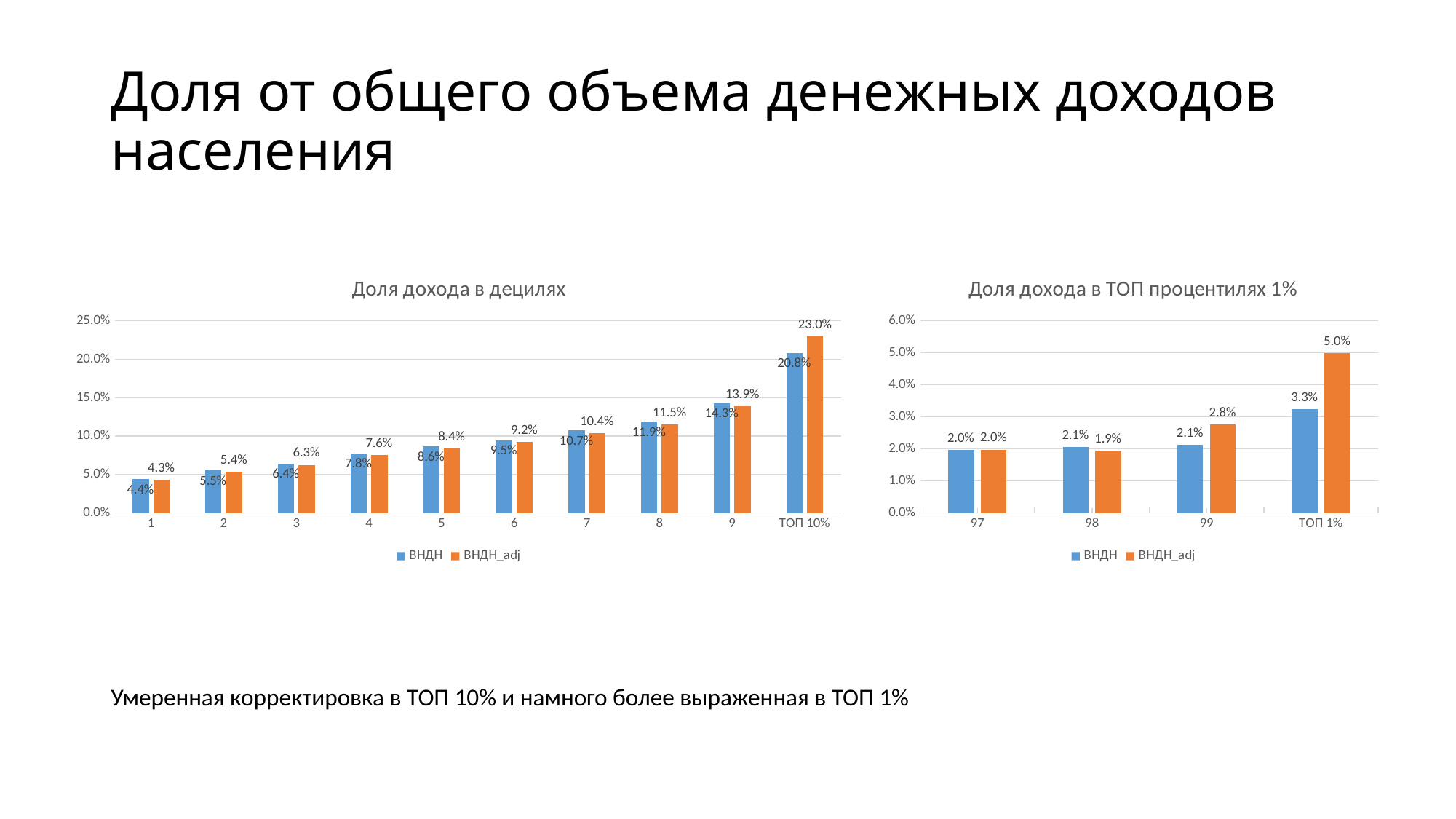
In the chart 'Доля дохода в ТОП процентилях 1%', what is the difference between the ВНДН_adj and ВНДН values for ТОП 1%? 1.7% In the chart 'Доля дохода в децилях', do the ВНДН values rise or fall from decile 1 to decile 9? rise What type of chart is 'Доля дохода в ТОП процентилях 1%'? bar chart In the chart 'Доля дохода в децилях', what is the ВНДН value for decile 5? 8.6% In the chart 'Доля дохода в децилях', what is the ВНДН_adj value for ТОП 10%? 23.0% How many series does the legend of the chart 'Доля дохода в ТОП процентилях 1%' list? 2 In the chart 'Доля дохода в ТОП процентилях 1%', which is larger for percentile 99: ВНДН or ВНДН_adj? ВНДН_adj In the chart 'Доля дохода в децилях', how many categories are shown on the x axis? 10 In the chart 'Доля дохода в ТОП процентилях 1%', what is the ВНДН_adj value for ТОП 1%? 5.0% In the chart 'Доля дохода в децилях', which category has the highest ВНДН value? ТОП 10% In the chart 'Доля дохода в децилях', what is the difference between the ВНДН_adj and ВНДН values for ТОП 10%? 2.2% In the chart 'Доля дохода в децилях', which category has the lowest ВНДН_adj value? 1